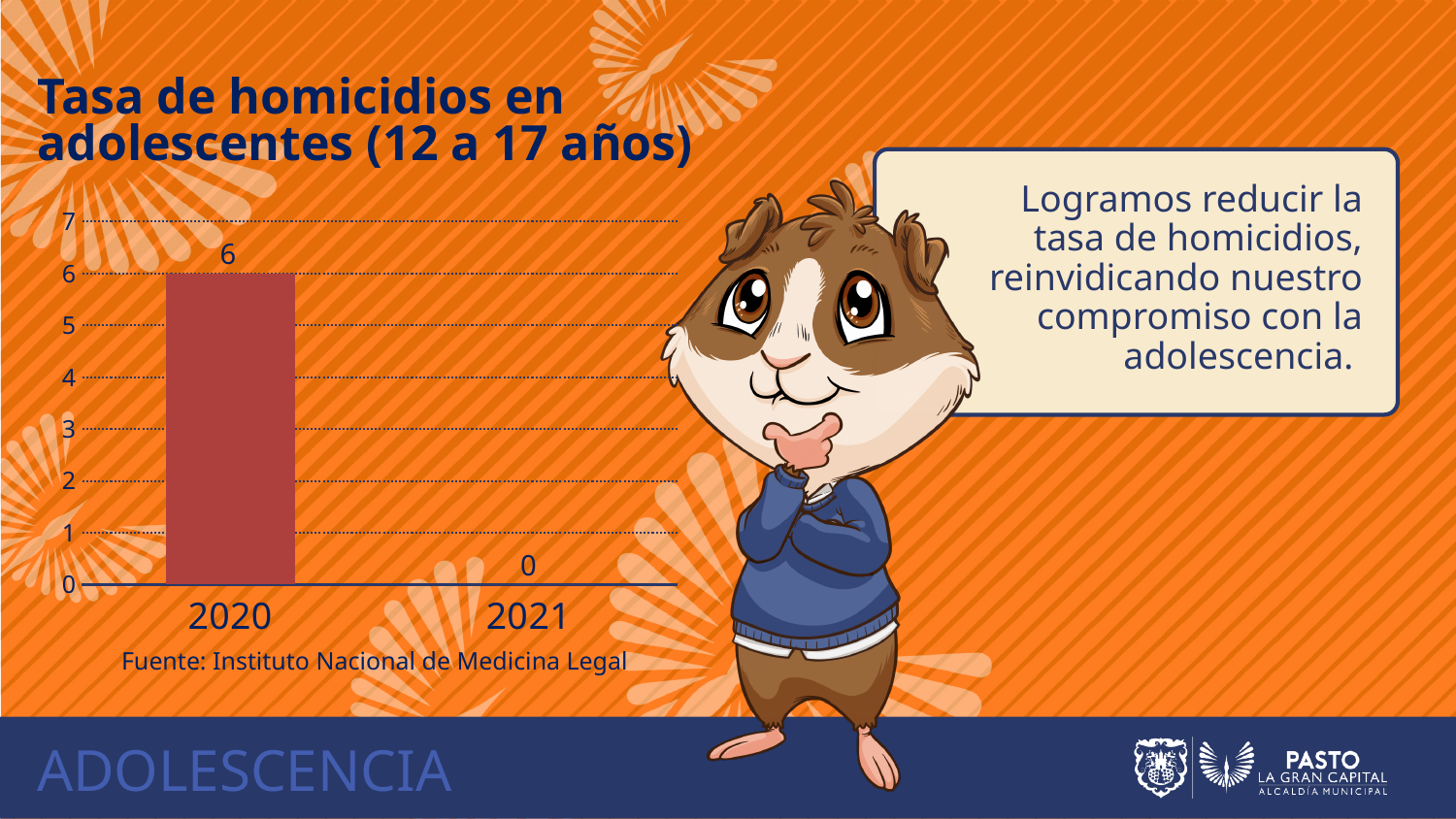
Which year has the lowest homicide rate? 2021 What is the homicide rate for adolescents in 2021? 0 What is the difference between the 2020 and 2021 values? 6 What is the highest value shown on the y axis? 7 What kind of chart is shown on the slide? Bar chart Do the values rise or fall from 2020 to 2021? Fall How many years are shown on the x axis? 2 Is the value for 2020 greater or less than 5? greater Which year has the higher homicide rate? 2020 What source is cited below the chart? Instituto Nacional de Medicina Legal What is the homicide rate for adolescents in 2020? 6 What is the title of the chart? Tasa de homicidios en adolescentes (12 a 17 años)